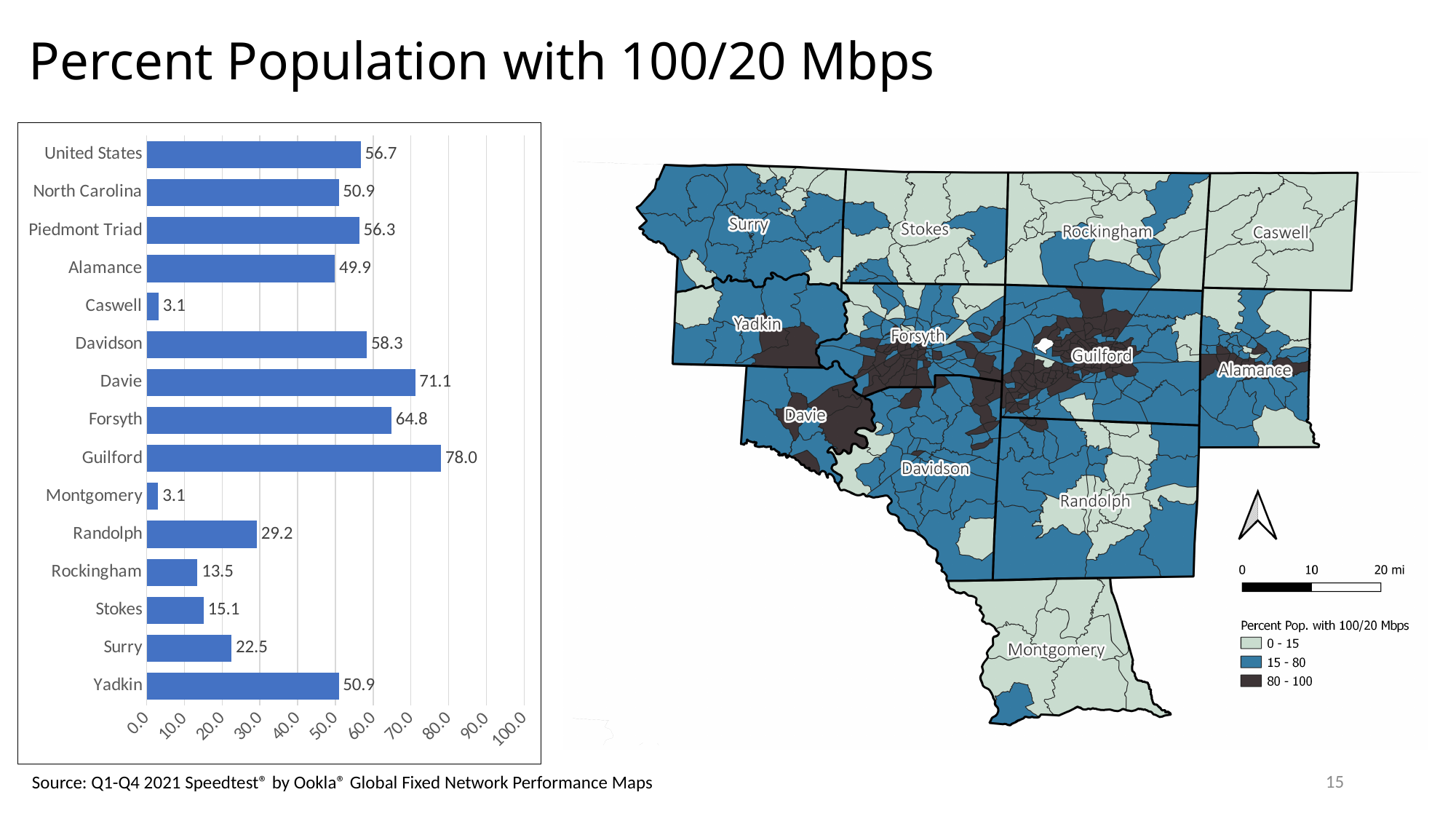
What is the title of the slide containing the bar chart? Percent Population with 100/20 Mbps Which category has the highest value in the bar chart? Guilford What is the value for Guilford in the bar chart? 78.0 What kind of chart is shown on the left of the slide? Bar chart What is the value for Davie in the bar chart? 71.1 What is the value for the United States in the bar chart? 56.7 What is the difference between the values for Piedmont Triad and North Carolina in the bar chart? 5.4 What is the value for Rockingham in the bar chart? 13.5 Which has a larger value in the bar chart, Davidson or Alamance? Davidson How many categories are shown in the bar chart? 15 What is the difference between the values for Guilford and Forsyth in the bar chart? 13.2 Which has a larger value in the bar chart, Surry or Stokes? Surry